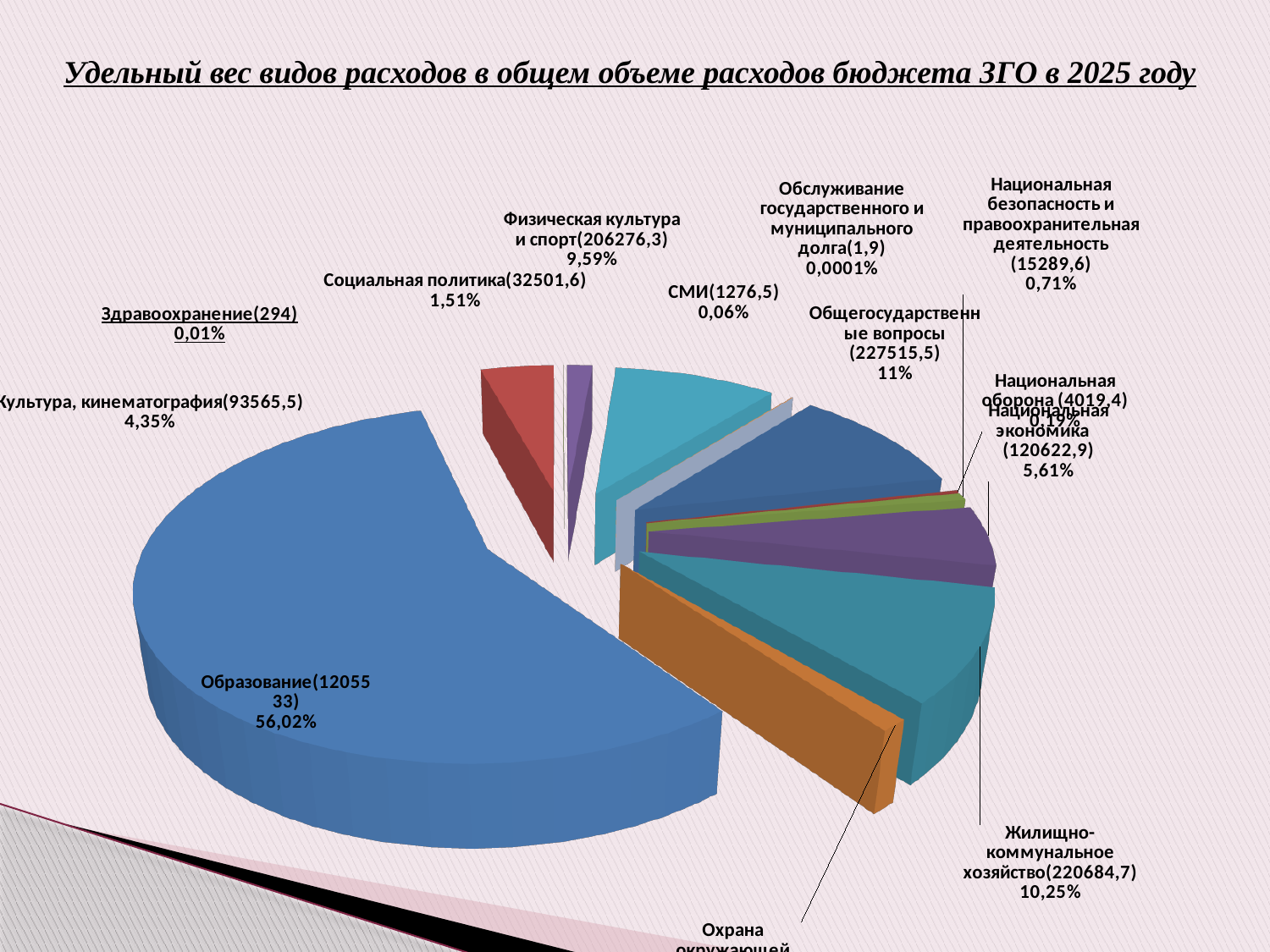
What kind of chart is shown on the slide? pie chart What is the title of the chart? Удельный вес видов расходов в общем объеме расходов бюджета ЗГО в 2025 году What share of total expenditure does Здравоохранение account for? 0,01% What value is shown for Физическая культура и спорт? 206276,3 Which category has the largest share of the pie? Образование Which category has the smallest share of the pie? Обслуживание государственного и муниципального долга Which has a larger share: Физическая культура и спорт or Национальная экономика? Физическая культура и спорт What share of total expenditure does Жилищно-коммунальное хозяйство account for? 10,25% What is the difference in percentage share between Общегосударственные вопросы and Жилищно-коммунальное хозяйство? 0,75% What share of total expenditure does Образование account for? 56,02% What value is shown for Национальная экономика? 120622,9